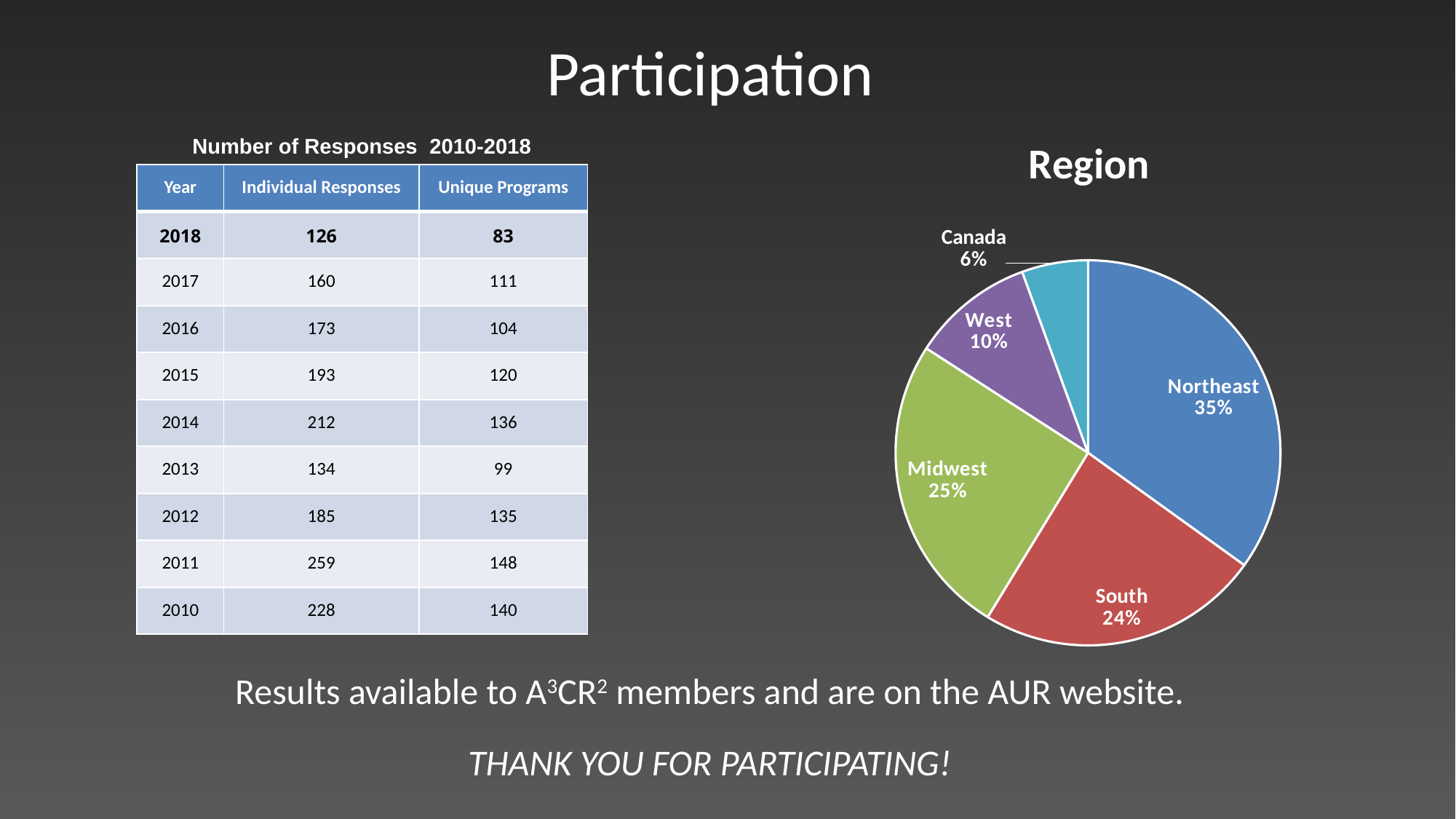
In the Region pie chart, what share does Midwest have? 25% In the Region pie chart, how many slices are there? 5 What kind of chart is the Region chart? pie chart In the Region pie chart, which region has the largest share? Northeast In the Region pie chart, what share does South have? 24% In the Region pie chart, what is the difference between the Northeast and South shares? 11% What is the title of the pie chart on the slide? Region In the Region pie chart, what share does West have? 10% In the Region pie chart, which is larger, the Midwest share or the South share? Midwest In the Region pie chart, which region has the smallest share? Canada In the Region pie chart, what share does Northeast have? 35% In the Region pie chart, what share does Canada have? 6%